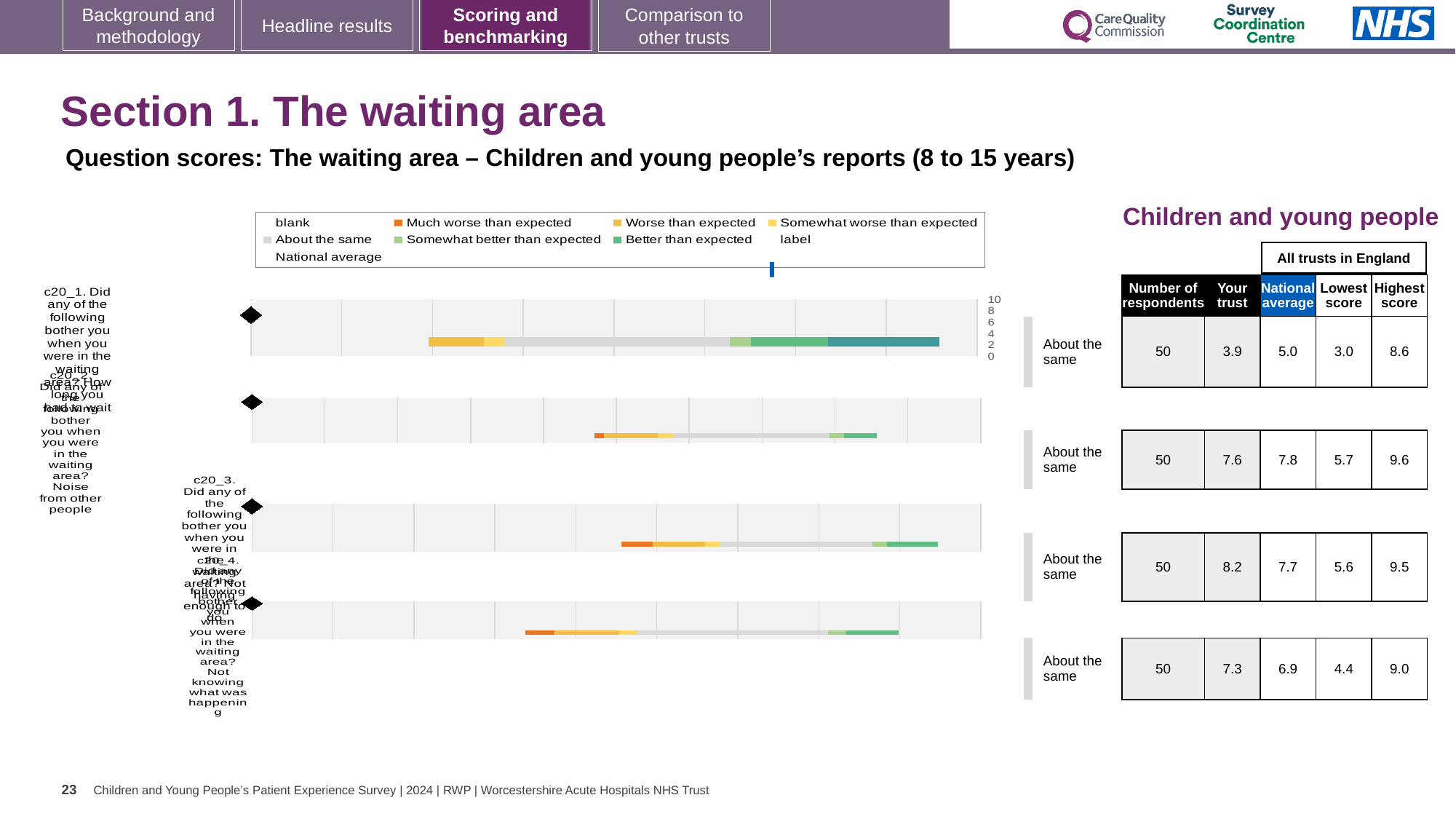
Which question has the lowest 'Your trust' score in the table beside the chart? c20_1 For question c20_4, which is larger: the 'Your trust' score or the national average? Your trust According to the table beside the chart, what is the 'Your trust' score for question c20_3? 8.2 What is the maximum value shown on the chart's score axis? 10 Which question has the highest 'Your trust' score in the table beside the chart? c20_3 Which colour does the legend use for 'Much worse than expected'? orange According to the table beside the chart, what is the 'Your trust' score for question c20_1? 3.9 For question c20_2, what is the difference between the national average (7.8) and the 'Your trust' score (7.6)? 0.2 How many respondents are listed for each question in the table beside the chart? 50 What kind of chart is shown on the slide? bar chart How many horizontal bars (questions) are plotted in the chart? 4 What is the highest score across all trusts in England for question c20_2? 9.6